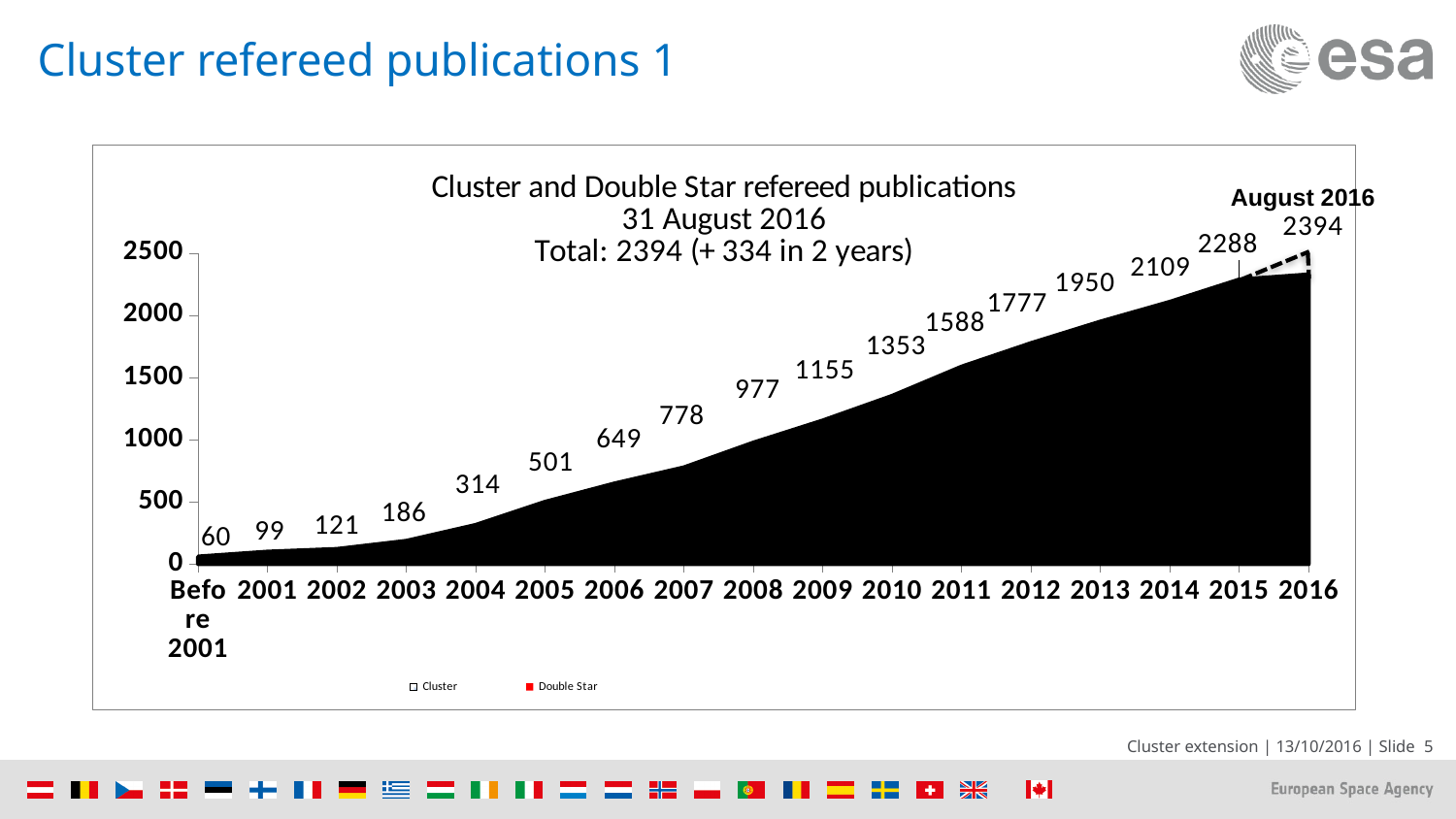
How many series does the legend list? 2 What is the value shown for 2005? 501 How many categories are shown along the x axis? 17 Which category has the lowest value on the chart? Before 2001 What is the difference between the values for 2008 and 2007? 199 Do the values rise or fall from left to right along the x axis? rise What is the title of the chart? Cluster and Double Star refereed publications 31 August 2016 Total: 2394 (+ 334 in 2 years) Which is larger, the value for 2012 or the value for 2011? 2012 What is the value shown for 2010? 1353 What is the value shown for the 'Before 2001' category? 60 What is the difference between the values for 2016 and 2015? 106 Which year has the highest value on the chart? 2016